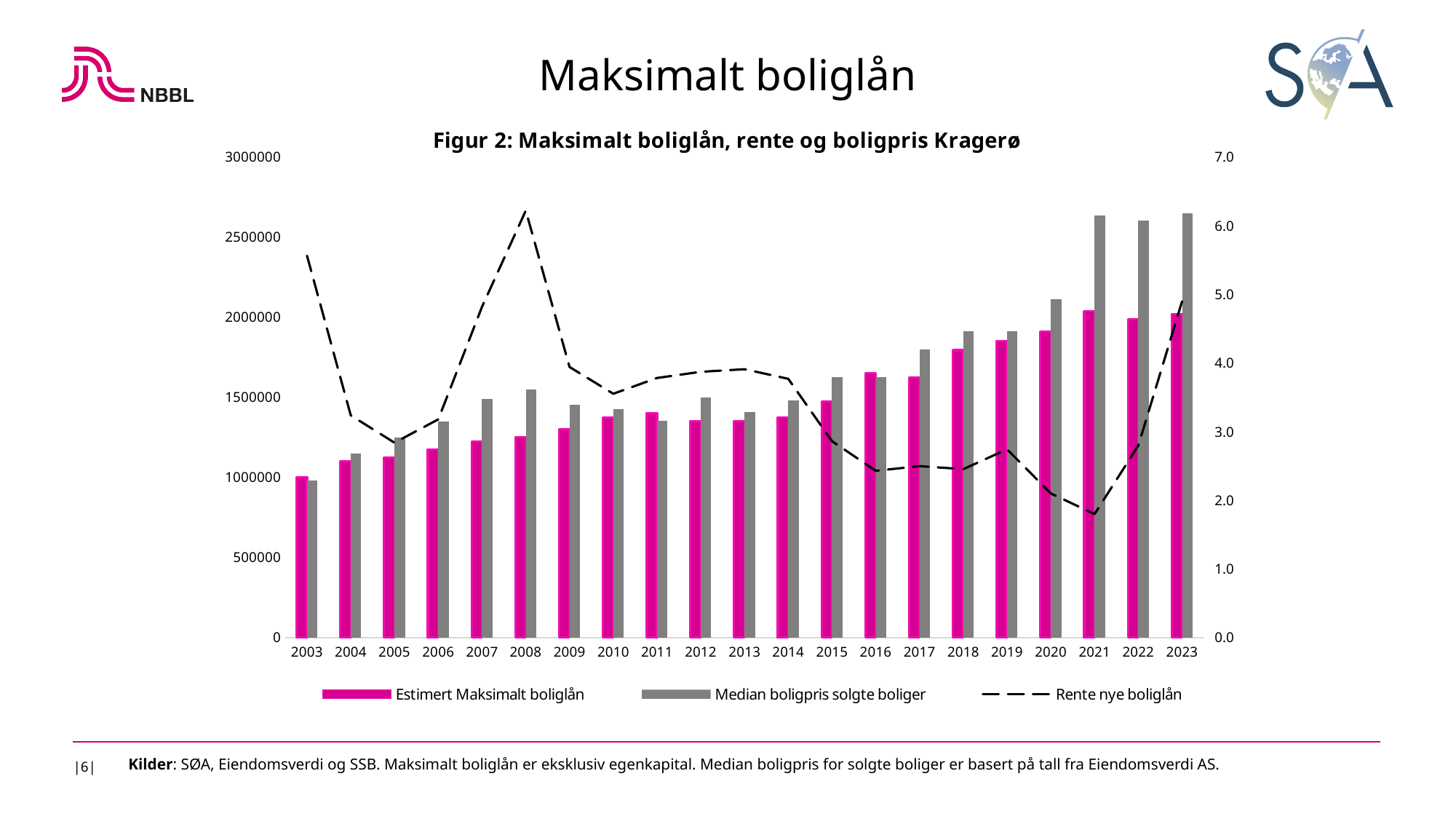
How many series does the legend list? 3 In which year is the Rente nye boliglån line at its highest? 2008 Is the Rente nye boliglån value for 2008 greater or less than 6.0? greater In 2008, which is larger: Estimert Maksimalt boliglån or Median boligpris solgte boliger? Median boligpris solgte boliger In 2011, which is larger: Estimert Maksimalt boliglån or Median boligpris solgte boliger? Estimert Maksimalt boliglån In which year is the Rente nye boliglån line at its lowest? 2021 Is the Median boligpris solgte boliger value for 2021 greater or less than 2500000? greater Is the Estimert Maksimalt boliglån value for 2021 greater or less than 2000000? greater What kind of chart is shown on the slide? A bar chart combined with a dashed line In which year is the Estimert Maksimalt boliglån bar the lowest? 2003 What is the title of the chart? Figur 2: Maksimalt boliglån, rente og boligpris Kragerø How many years are shown on the x axis? 21